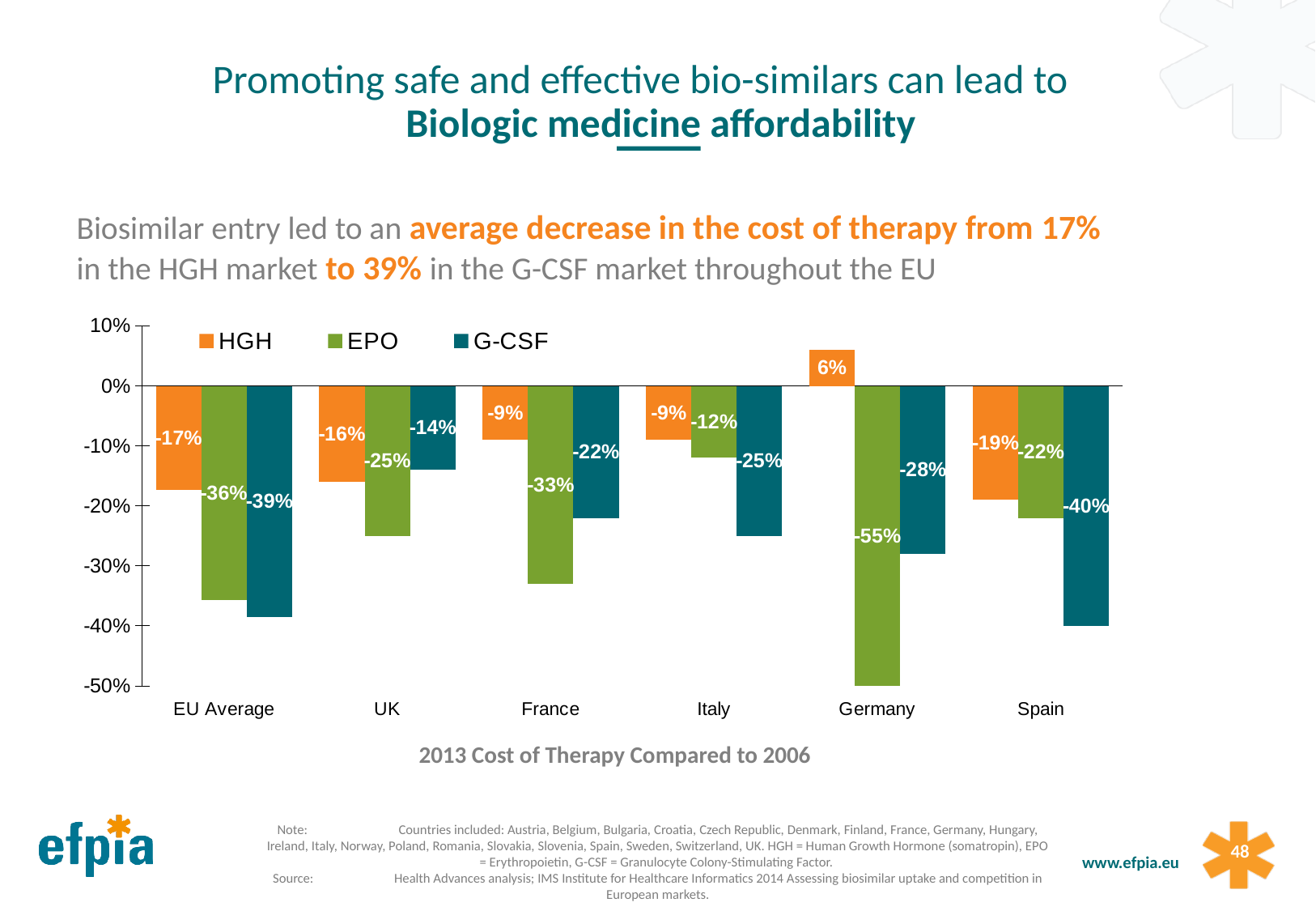
What is the caption printed below the chart? 2013 Cost of Therapy Compared to 2006 What is the value for G-CSF in Germany? -28% Which country shows the lowest EPO value? Germany Which is lower in Italy, the EPO value or the G-CSF value? G-CSF Which country has the only positive value on the chart, and for which series? Germany, HGH (6%) How many countries or groups are shown on the x axis? 6 What is the difference between the G-CSF value for Spain and the G-CSF value for the UK? 26 percentage points How many series does the legend list? 3 What is the value for HGH in the EU Average group? -17% What is the value for EPO in France? -33% Which country shows the lowest G-CSF value? Spain What kind of chart is shown on the slide? Bar chart